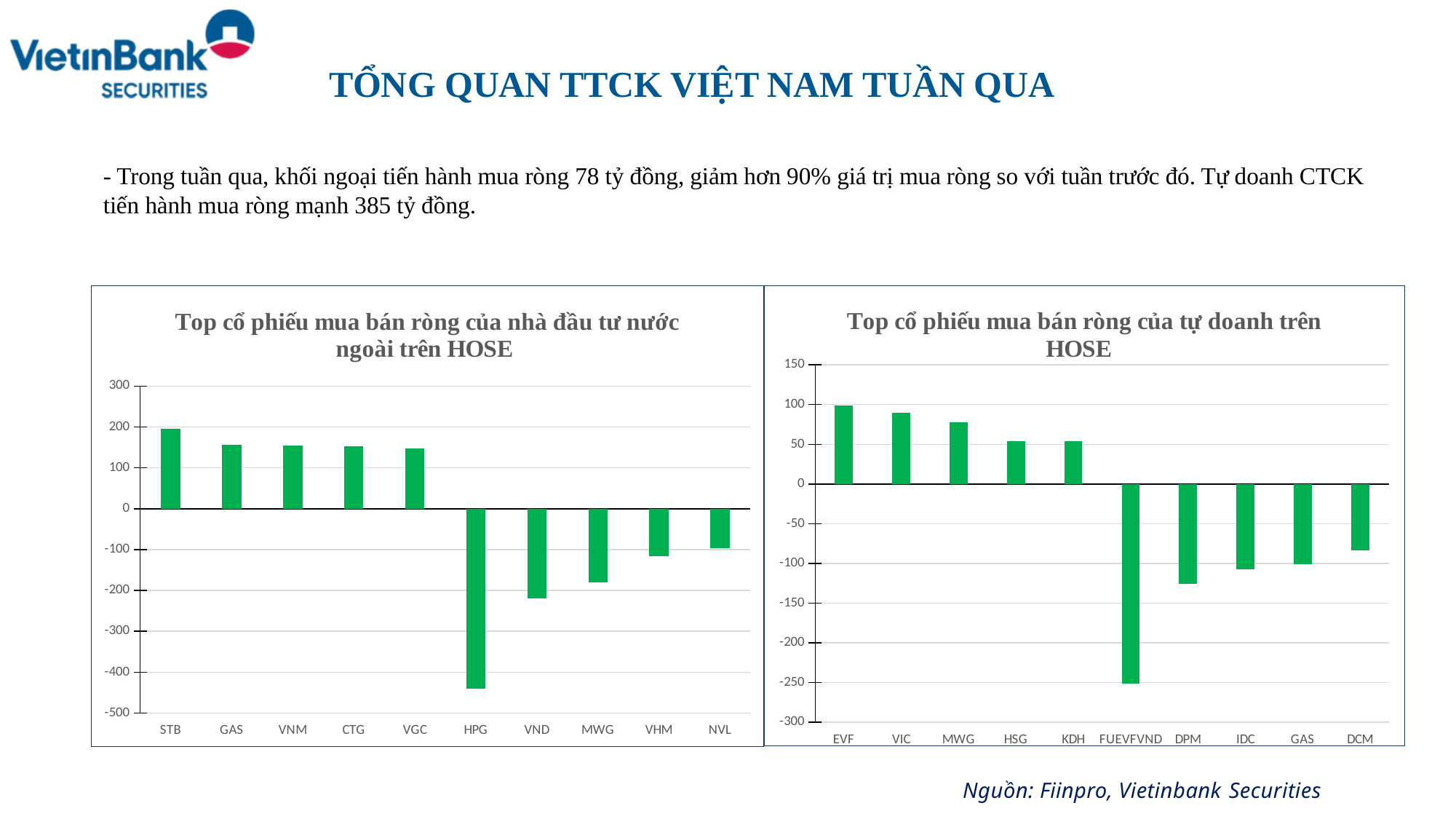
In the chart 'Top cổ phiếu mua bán ròng của tự doanh trên HOSE', how many stocks are shown? 10 In the chart 'Top cổ phiếu mua bán ròng của tự doanh trên HOSE', is the value for EVF greater or less than 50? greater In the chart 'Top cổ phiếu mua bán ròng của nhà đầu tư nước ngoài trên HOSE', is the value for HPG greater or less than -400? less In the chart 'Top cổ phiếu mua bán ròng của nhà đầu tư nước ngoài trên HOSE', is the value for STB greater or less than 100? greater In the chart 'Top cổ phiếu mua bán ròng của nhà đầu tư nước ngoài trên HOSE', which is larger, the value for VND or the value for MWG? MWG In the chart 'Top cổ phiếu mua bán ròng của nhà đầu tư nước ngoài trên HOSE', how many stocks are shown? 10 In the chart 'Top cổ phiếu mua bán ròng của tự doanh trên HOSE', which stock has the lowest value? FUEVFVND In the chart 'Top cổ phiếu mua bán ròng của tự doanh trên HOSE', which stock has the highest value? EVF In the chart 'Top cổ phiếu mua bán ròng của nhà đầu tư nước ngoài trên HOSE', which stock has the lowest value? HPG In the chart 'Top cổ phiếu mua bán ròng của nhà đầu tư nước ngoài trên HOSE', which stock has the highest value? STB What kind of chart is 'Top cổ phiếu mua bán ròng của tự doanh trên HOSE'? bar chart